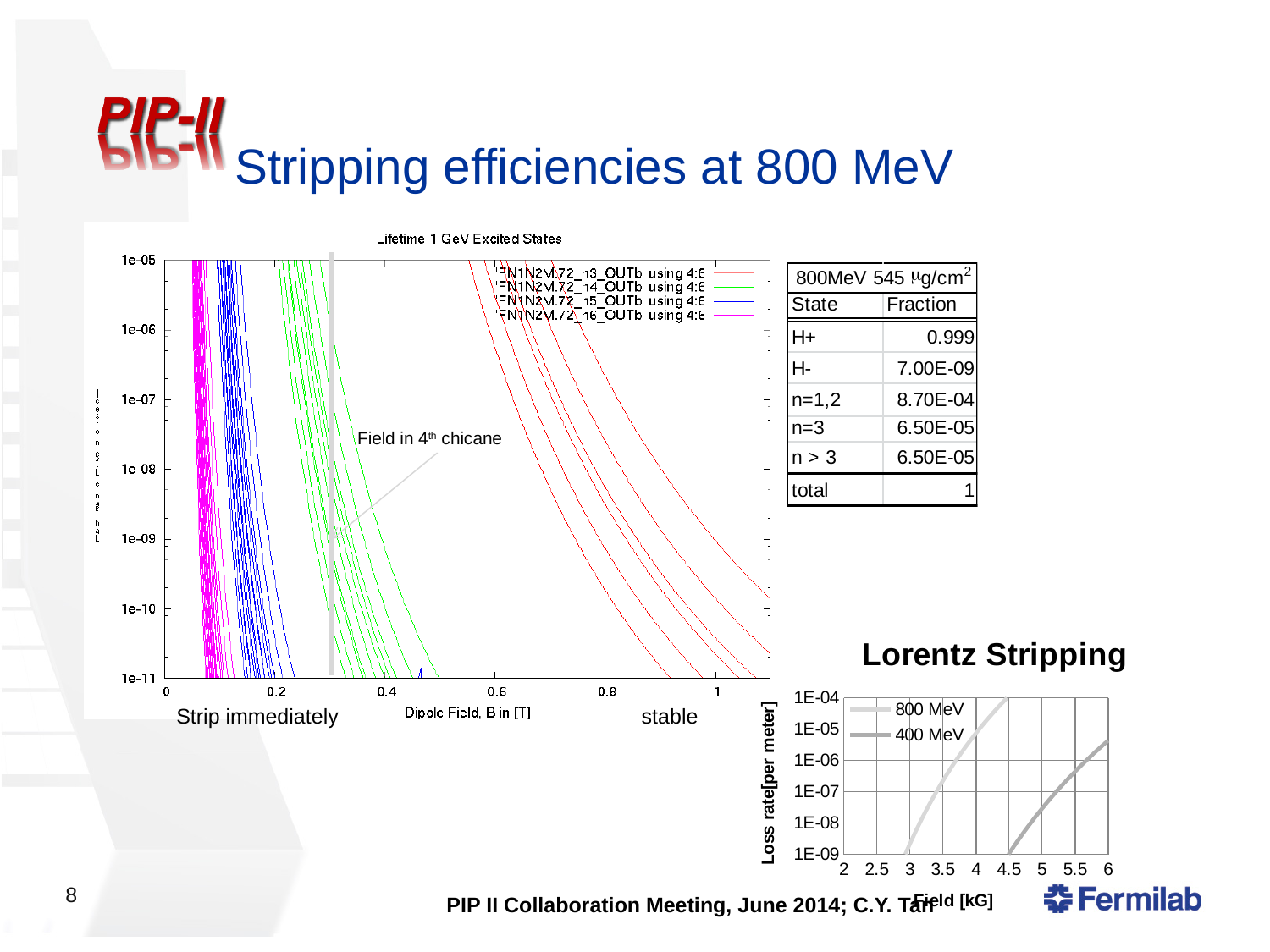
How many series does the legend of the 'Lifetime 1 GeV Excited States' chart list? 4 What kind of chart is the 'Lorentz Stripping' chart? line chart In the 'Lorentz Stripping' chart, is the loss rate for 800 MeV at 3.5 kG greater or less than 1E-08? greater What kind of chart is the 'Lifetime 1 GeV Excited States' chart? line chart How many series does the legend of the 'Lorentz Stripping' chart list? 2 In the 'Lorentz Stripping' chart, is the loss rate for 400 MeV at 6 kG greater or less than 1E-07? greater In the 'Lorentz Stripping' chart, at a field of 4 kG, which series has the higher loss rate, 800 MeV or 400 MeV? 800 MeV In the 'Lorentz Stripping' chart, which two energies are shown in the legend? 800 MeV and 400 MeV In the 'Lorentz Stripping' chart, does the loss rate rise or fall as the field increases? rise In the 'Lifetime 1 GeV Excited States' chart, do the lifetimes rise or fall as the dipole field increases? fall What is the x-axis label of the 'Lorentz Stripping' chart? Field [kG]